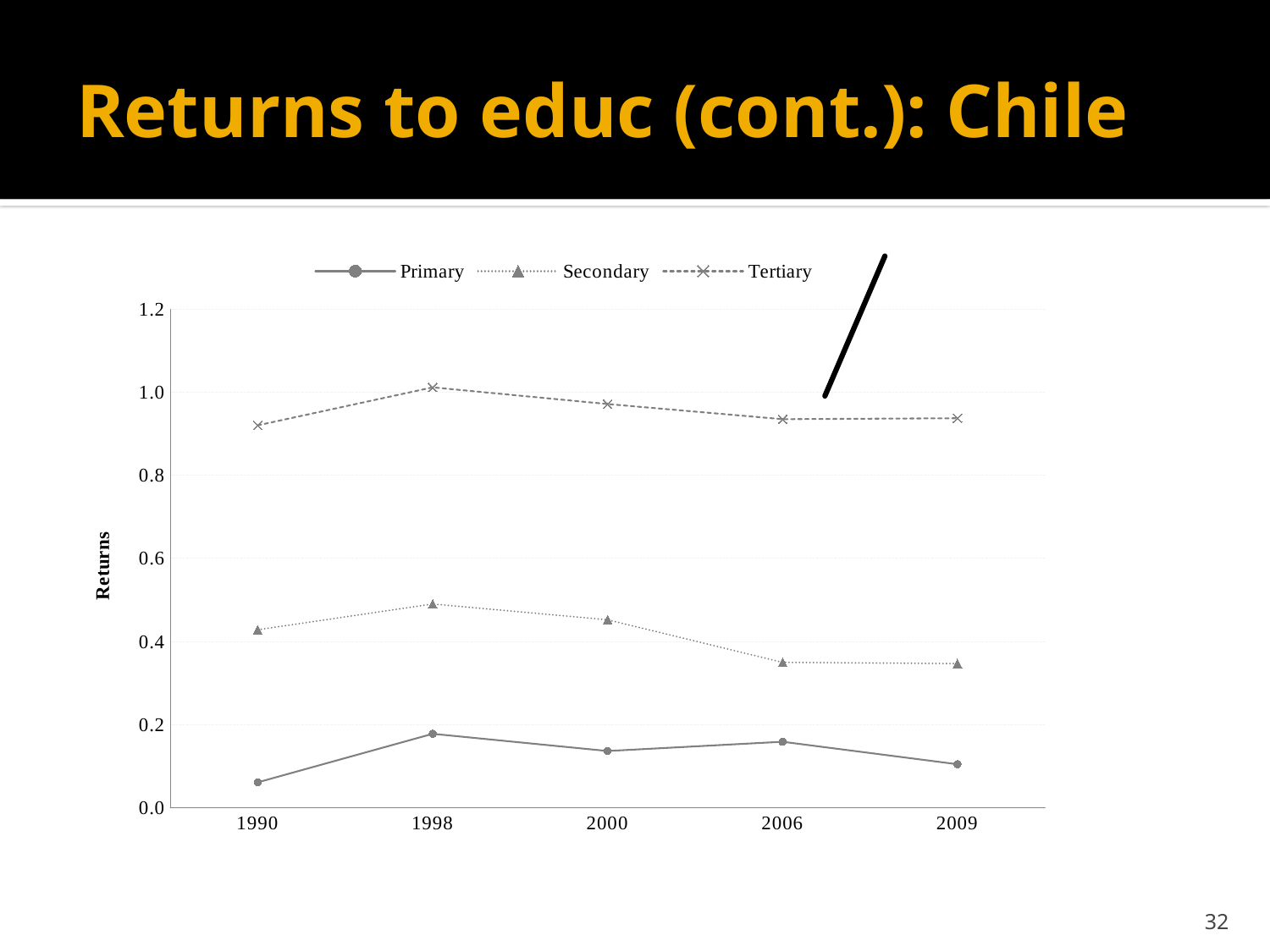
How many years are plotted along the x axis? 5 In which year does the Tertiary series reach its highest value? 1998 Is the Secondary value for 1998 greater or less than 0.4? greater Is the Primary value for 1990 greater or less than 0.2? less What is the label on the y axis? Returns Which is larger, the Secondary value in 1998 or in 2006? 1998 In which year does the Secondary series reach its highest value? 1998 Does the Secondary series rise or fall from 1998 to 2009? fall How many series does the legend list? 3 Is the Tertiary value for 1990 greater or less than 1.0? less What kind of chart is shown on the slide? line chart